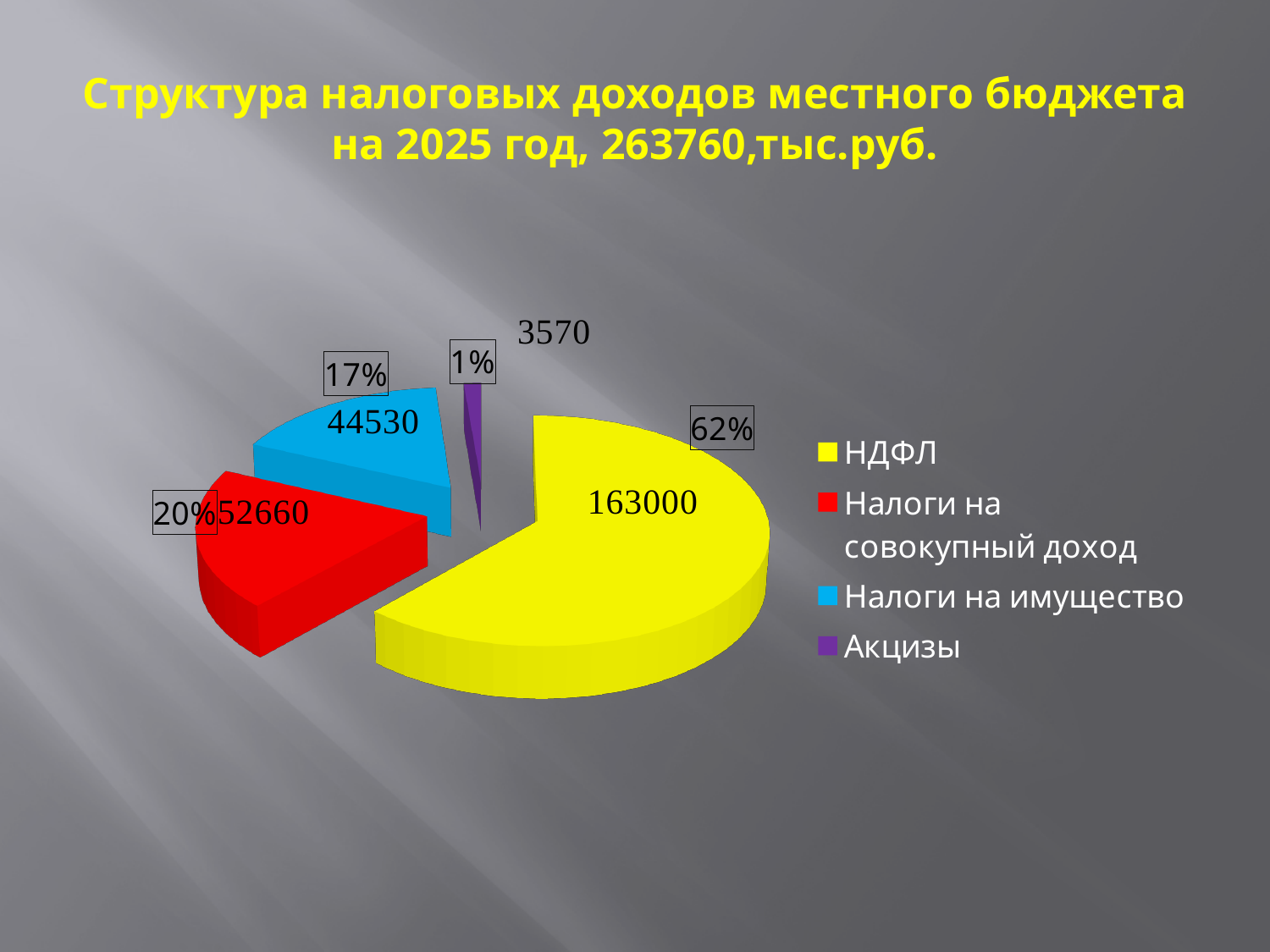
What is the value for Налоги на совокупный доход? 52660 What share of the pie does Налоги на имущество represent? 17% Which category has the smallest slice? Акцизы What is the value for НДФЛ? 163000 What kind of chart is shown on the slide? Pie chart What share of the pie does НДФЛ represent? 62% What is the value for Налоги на имущество? 44530 Which category has the largest slice? НДФЛ What is the difference between the values for Налоги на совокупный доход and Налоги на имущество? 8130 What colour is the slice for Акцизы? Purple What is the value for Акцизы? 3570 How many categories does the pie chart have? 4